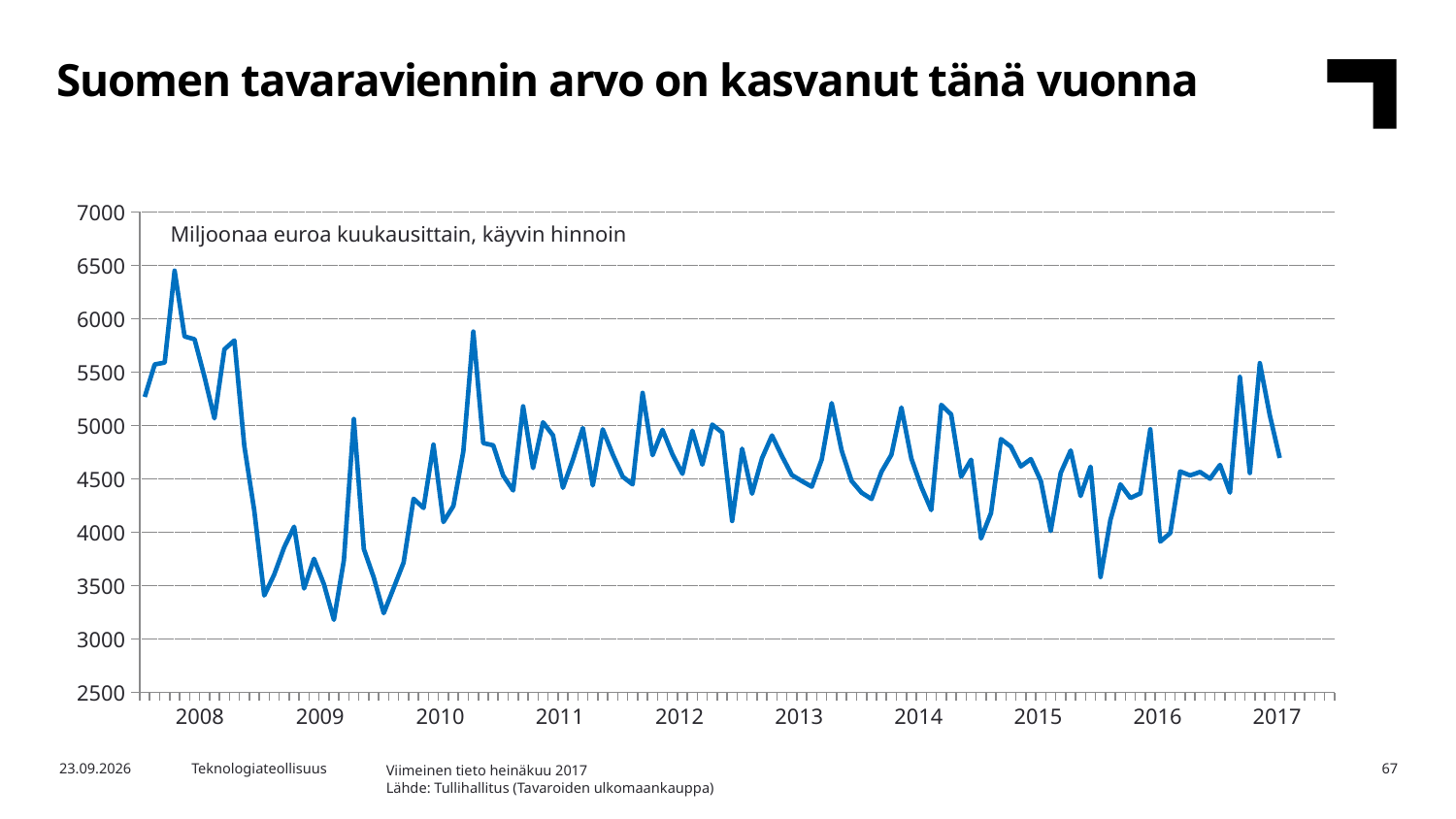
In which year does the line reach its highest peak? 2008 Is the highest peak in 2008 greater or less than 6000? greater In which year does the line reach its lowest point? 2009 Does the line rise or fall from the start of 2008 to the start of 2009? fall How many year labels are shown on the x axis? 10 What is the lowest value shown on the y axis? 2500 Is the lowest point in 2009 greater or less than 3500? less What unit description is printed inside the chart area? Miljoonaa euroa kuukausittain, käyvin hinnoin What is the highest value shown on the y axis? 7000 What kind of chart is shown on the slide? line chart What is the title of the slide? Suomen tavaraviennin arvo on kasvanut tänä vuonna